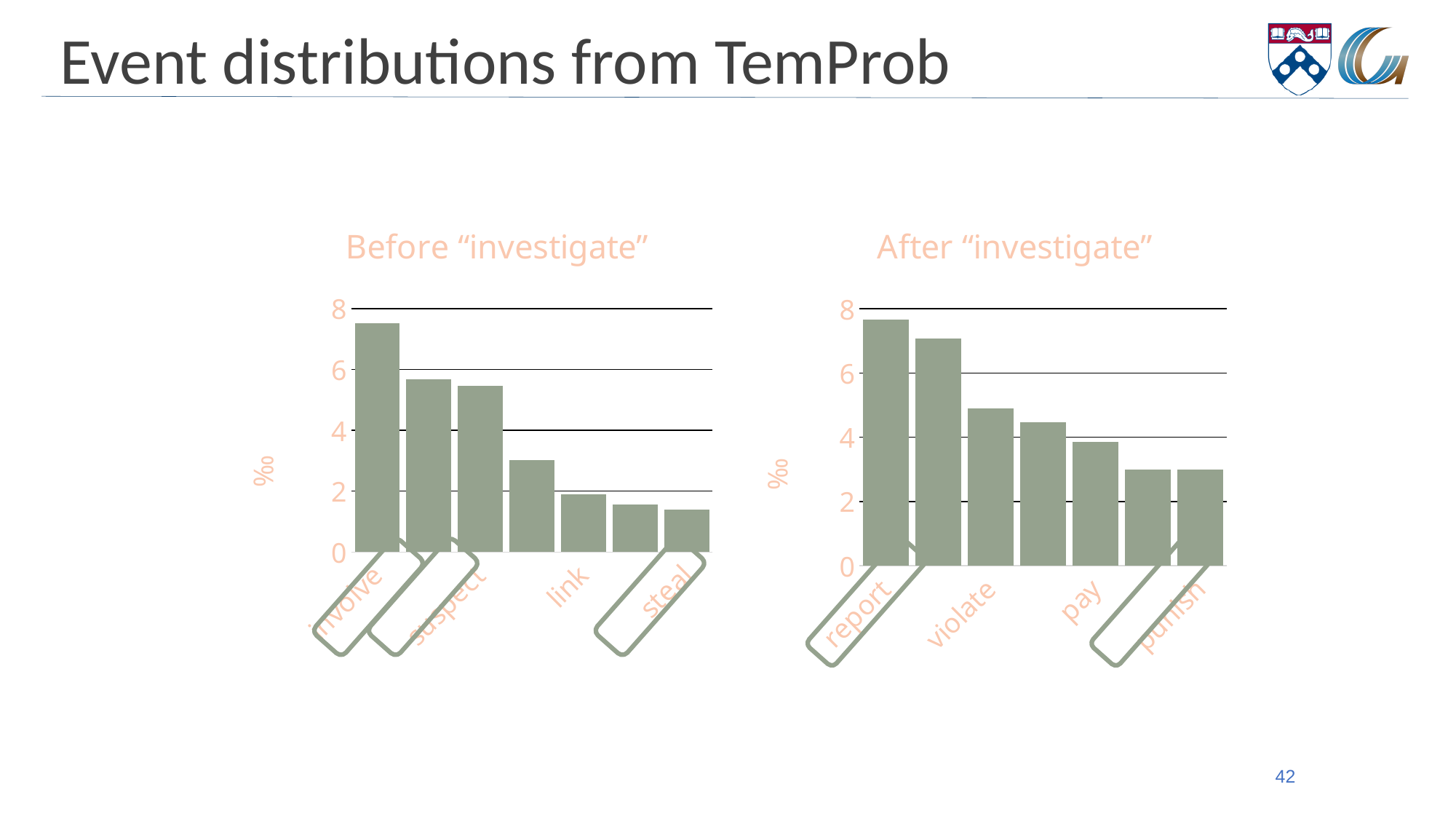
In the "Before "investigate"" chart, is the value for involve greater or less than 6? greater In the "After "investigate"" chart, do the bar values rise or fall from left to right? fall What unit is shown on the y axis of the "After "investigate"" chart? ‰ In the "Before "investigate"" chart, is the value for link greater or less than 4? less In the "After "investigate"" chart, which labelled event has the highest value? report In the "Before "investigate"" chart, which labelled event has the highest value? involve In the "After "investigate"" chart, is the value for violate greater or less than 4? greater How many bars are plotted in the "Before "investigate"" chart? 7 What kind of chart is used in the "Before "investigate"" chart? bar chart How many bars are plotted in the "After "investigate"" chart? 7 In the "Before "investigate"" chart, which is larger, the value for suspect or the value for link? suspect